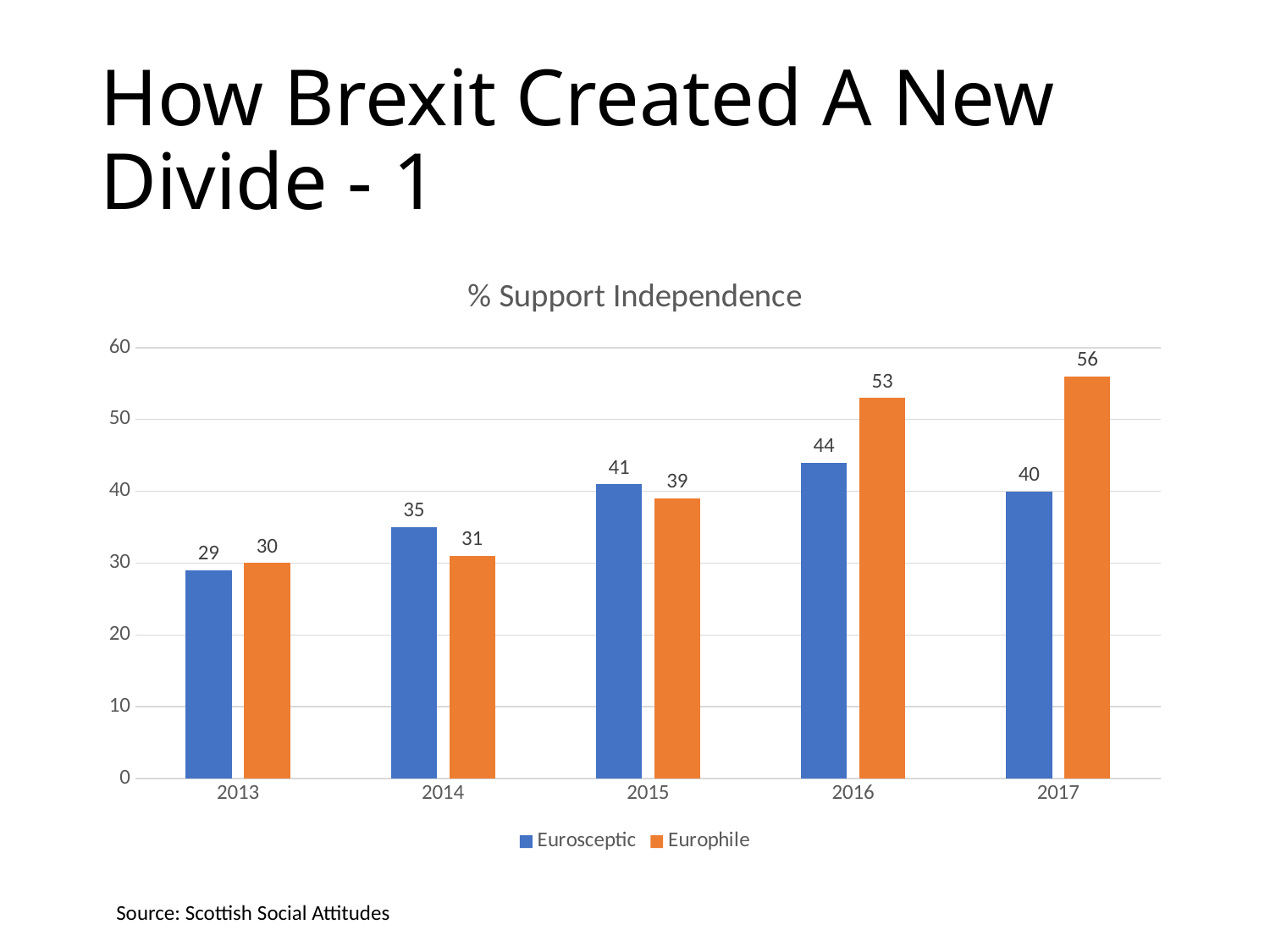
Is the Europhile value for 2016 greater or less than 50? greater What is the Europhile value for 2017? 56 In which year is the Europhile value highest? 2017 In which year is the Eurosceptic value lowest? 2013 What is the difference between the Europhile and Eurosceptic values in 2017? 16 How many series does the legend list? 2 What kind of chart is shown? bar chart What is the title of the chart? % Support Independence Does the Europhile series rise or fall from 2014 to 2017? rise What is the Eurosceptic value for 2015? 41 How many years are shown on the x axis? 5 Which series has the larger value in 2014, Eurosceptic or Europhile? Eurosceptic